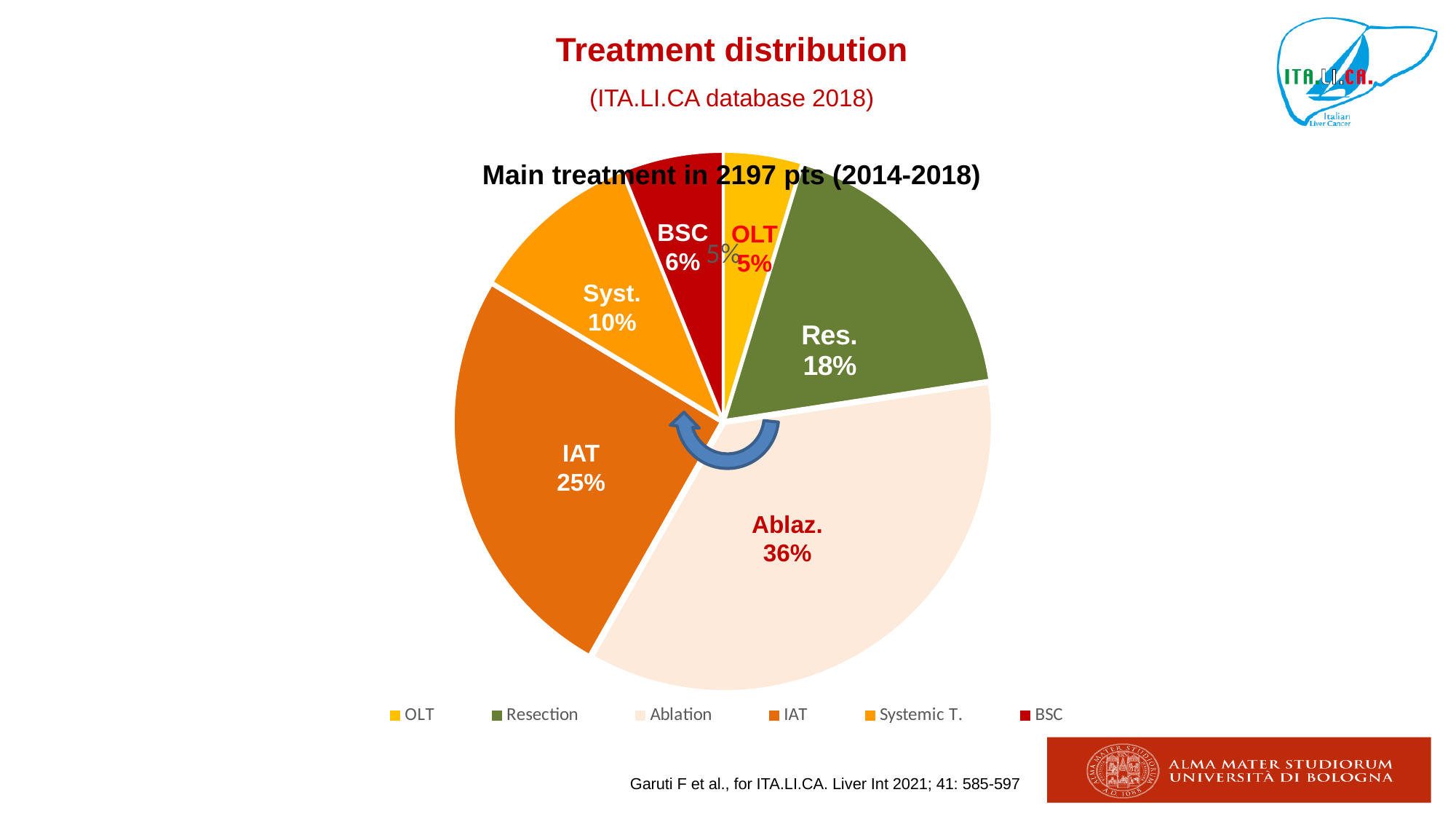
What percentage of patients received IAT? 25% What percentage of patients received systemic therapy (Syst.)? 10% What type of chart is shown on the slide? pie chart What percentage of patients received BSC? 6% Which is larger, the share for Res. or the share for Syst.? Res. What is the chart's title? Main treatment in 2197 pts (2014-2018) What is the difference in percentage points between the Ablaz. slice and the IAT slice? 11 What percentage of patients received ablation (Ablaz.)? 36% What percentage of patients received resection (Res.)? 18% Which treatment has the largest share of the pie? Ablation (Ablaz.) How many treatment categories does the legend list? 6 Which treatment has the smallest share of the pie? OLT